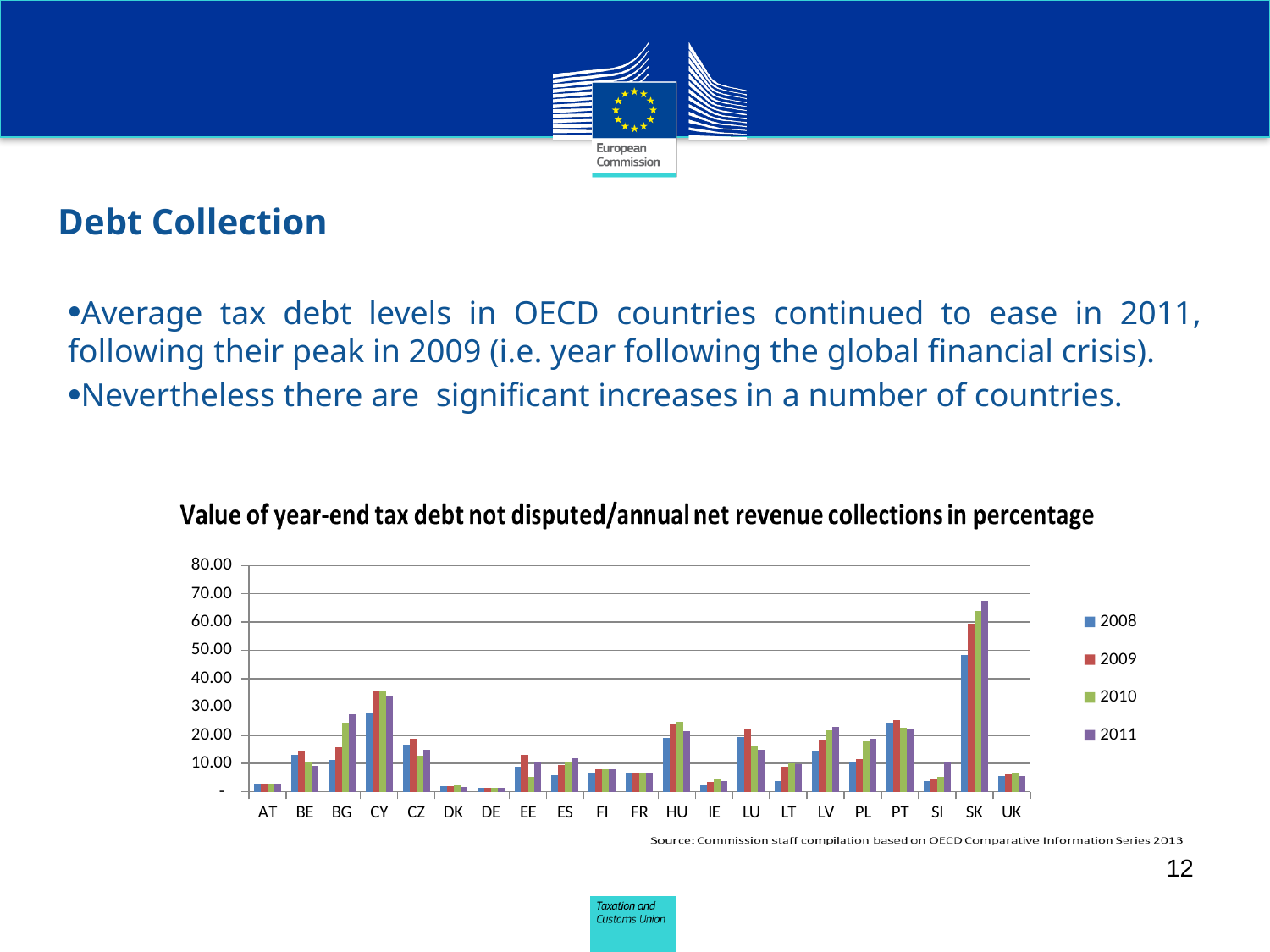
Do the values for SK rise or fall from 2008 to 2011? rise How many countries are shown on the x axis of the chart? 21 Is the 2011 value for BG greater or less than 20? greater Is the 2011 value for SK greater or less than 60? greater Is the 2009 value for CY greater or less than 30? greater Which is larger in 2011, the value for HU or the value for IE? HU Which is larger in 2011, the value for CY or the value for BG? CY How many series does the chart legend list? 4 What kind of chart is shown on the slide? Bar chart What is the title of the chart? Value of year-end tax debt not disputed/annual net revenue collections in percentage Which country has the highest value in the chart? SK